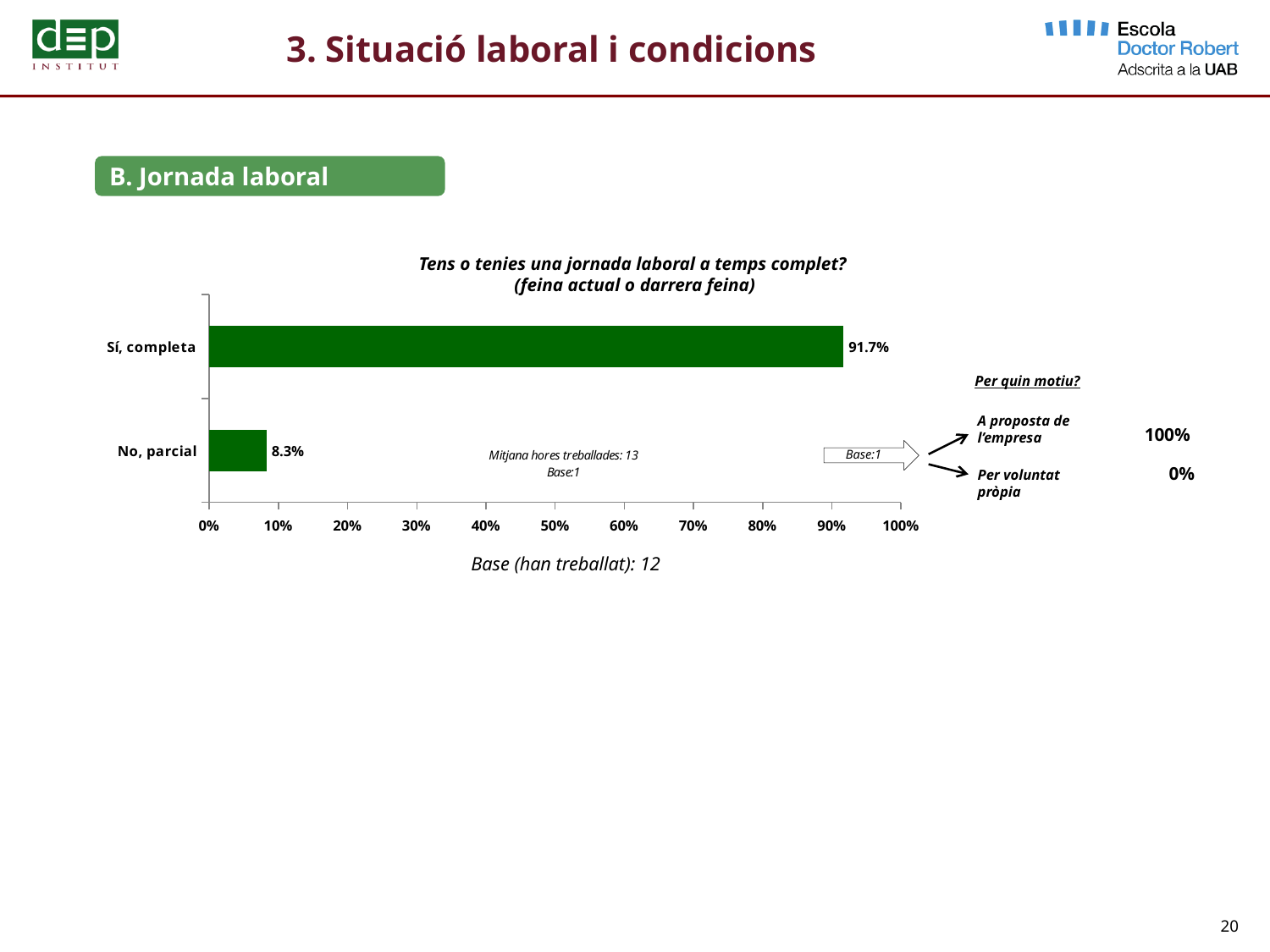
Which is larger, the value for "Sí, completa" or for "No, parcial"? Sí, completa Which category has the highest value? Sí, completa What is the value for "Sí, completa"? 91.7% What is the difference between the values for "Sí, completa" and "No, parcial"? 83.4% Is the value for "No, parcial" greater or less than 10%? less Which category has the lowest value? No, parcial What is the base (number of respondents) stated below the chart? 12 What is the title of the chart? Tens o tenies una jornada laboral a temps complet? (feina actual o darrera feina) Is the value for "Sí, completa" greater or less than 90%? greater How many categories are shown in the chart? 2 What is the value for "No, parcial"? 8.3% What kind of chart is shown on the slide? Bar chart